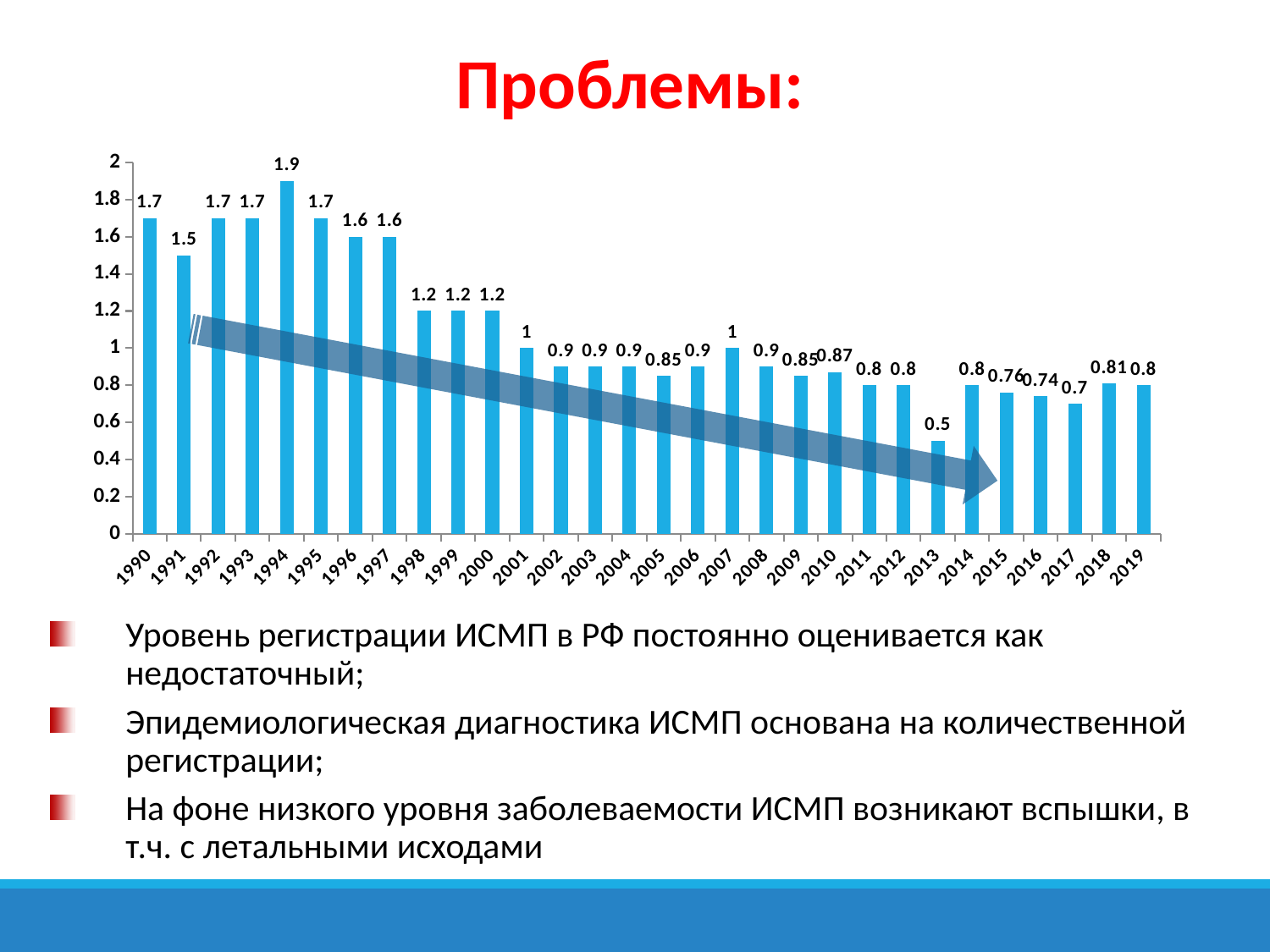
Do the values generally rise or fall from 1990 to 2019? Fall Which is larger, the value for 2015 or the value for 2017? 2015 How many years are shown on the x axis? 30 What is the difference between the values for 1994 and 2013? 1.4 What is the value shown for 1994? 1.9 What is the difference between the values for 1990 and 1991? 0.2 What is the value shown for 2019? 0.8 Which year has the highest value? 1994 What is the value shown for 2010? 0.87 Which year has the lowest value? 2013 What kind of chart is shown on the slide? Bar chart What is the value shown for 2013? 0.5